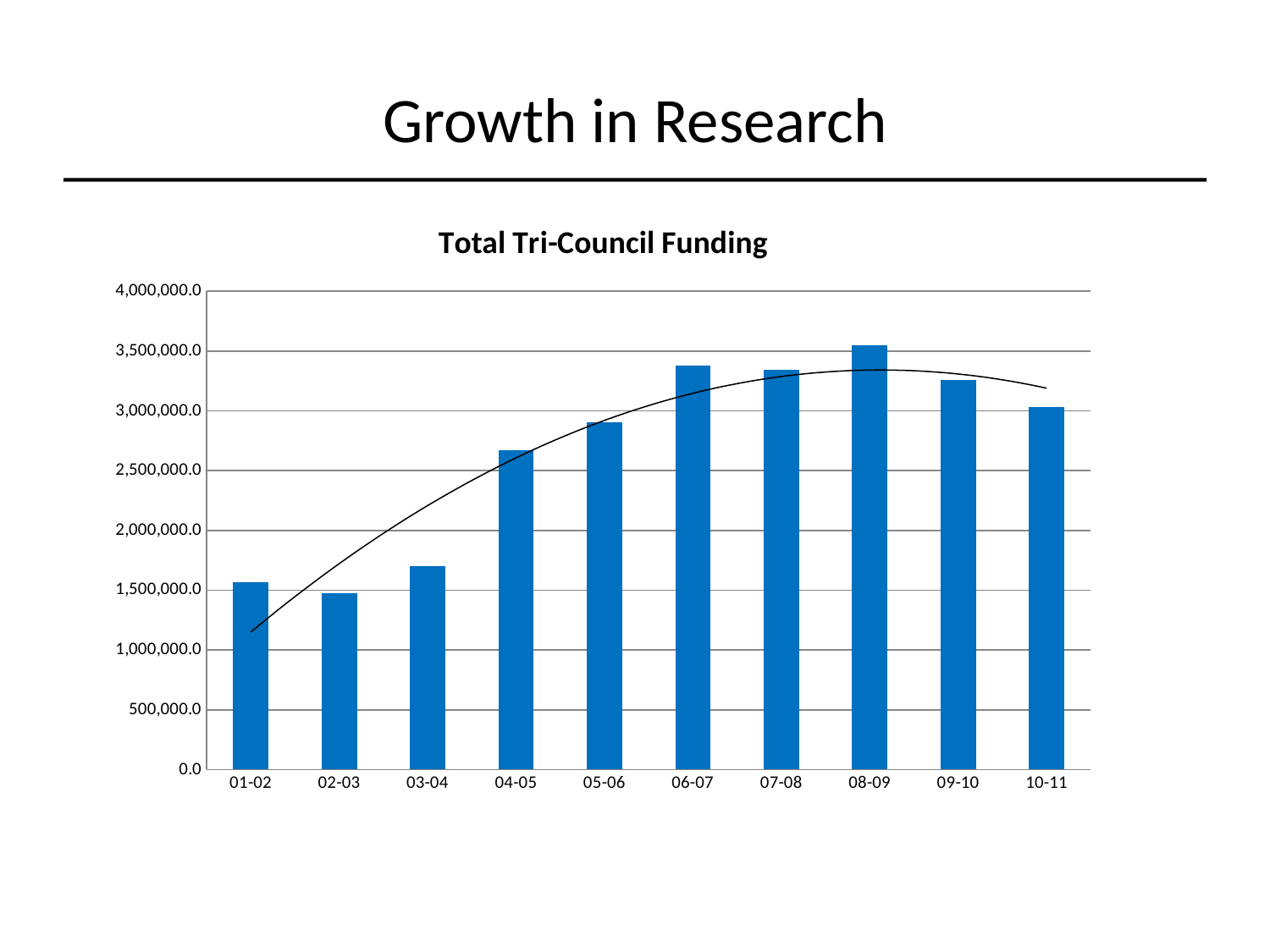
Which fiscal year has the highest Total Tri-Council Funding? 08-09 What is the title of the chart? Total Tri-Council Funding Which is larger, the value for 04-05 or the value for 03-04? 04-05 Which fiscal year has the lowest Total Tri-Council Funding? 02-03 Is the value for 03-04 greater or less than 2,000,000.0? less Is the value for 09-10 greater or less than 3,500,000.0? less Does the funding generally rise or fall from 01-02 to 08-09? rise Is the value for 05-06 greater or less than 3,000,000.0? less What kind of chart is shown on the slide? bar chart How many fiscal years are shown on the x axis of the chart? 10 Which is larger, the value for 09-10 or the value for 10-11? 09-10